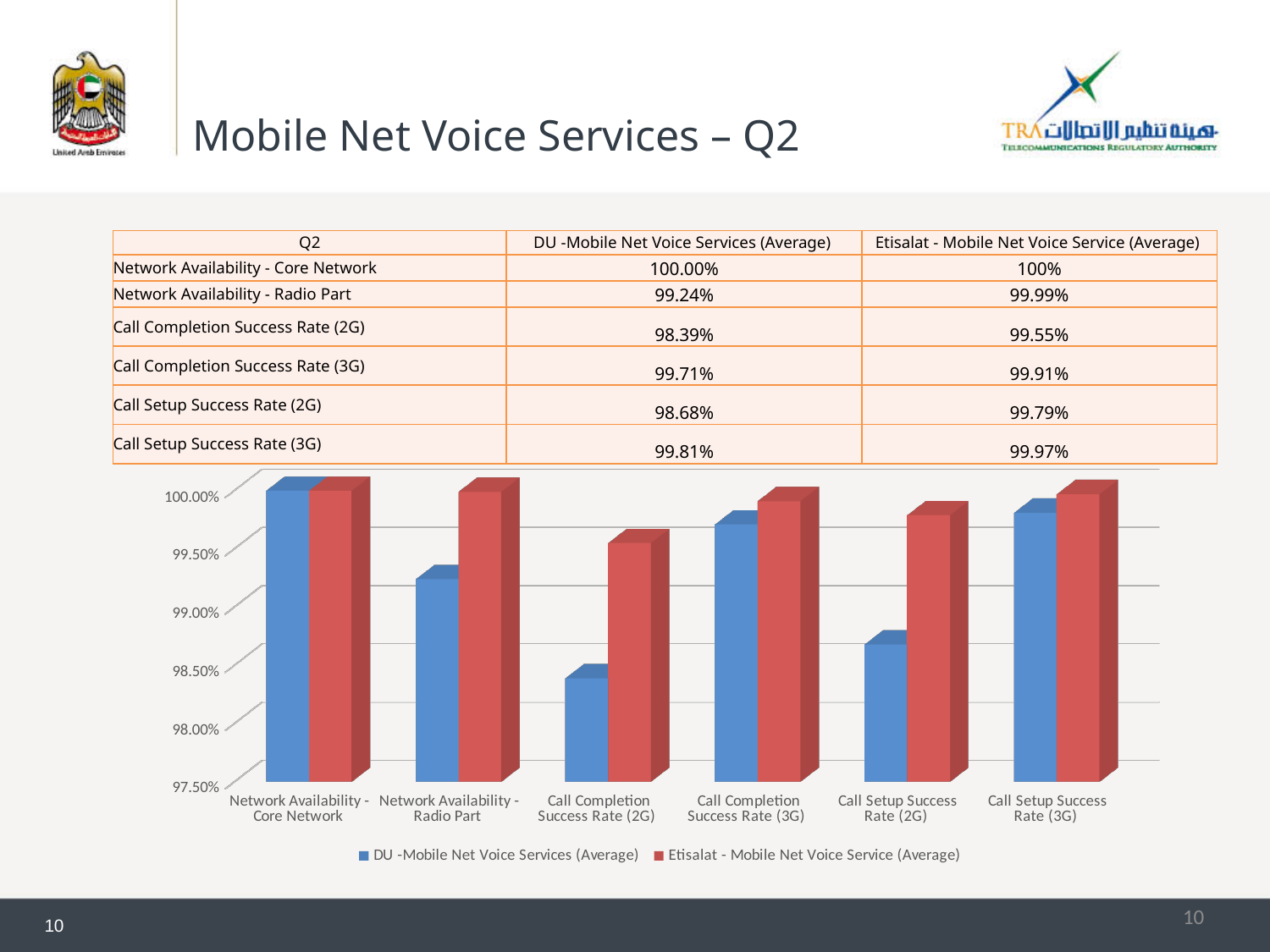
Which is larger for Call Setup Success Rate (2G): the DU value or the Etisalat value? Etisalat What is the Etisalat value for Network Availability - Radio Part? 99.99% How many categories are shown on the x axis of the chart? 6 Is the DU value for Network Availability - Radio Part greater or less than 99.00%? greater How many series does the chart legend list? 2 What is the DU value for Call Completion Success Rate (2G)? 98.39% Which category has the lowest Etisalat value? Call Completion Success Rate (2G) What is the difference between the Etisalat and DU values for Call Setup Success Rate (2G)? 1.11% What is the DU value for Call Setup Success Rate (3G)? 99.81% What kind of chart is shown on the slide? bar chart Which colour represents the Etisalat series in the chart? red Which category has the lowest DU value? Call Completion Success Rate (2G)